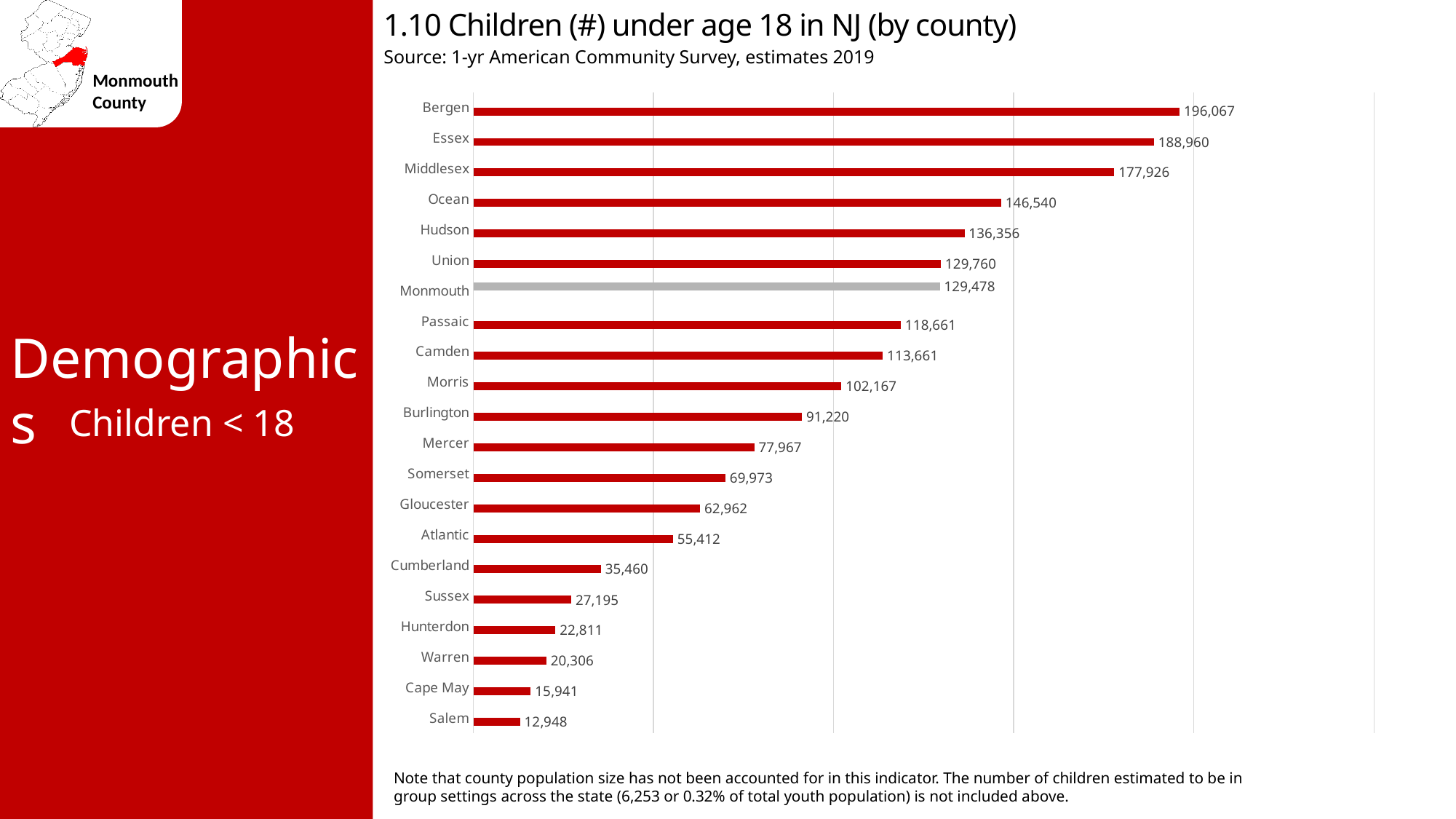
Which county has more children under age 18, Hudson or Passaic? Hudson What is the difference between the number of children under 18 in Union and Monmouth counties? 282 What is the number of children under age 18 in Monmouth County? 129,478 What type of chart is used on this slide? Bar chart What is the difference between the number of children under 18 in Bergen and Essex counties? 7,107 What is the number of children under age 18 in Ocean County? 146,540 Which county's bar is shown in grey instead of red? Monmouth What is the number of children under age 18 in Cape May County? 15,941 How many counties are shown in the chart? 21 Which county has more children under age 18, Sussex or Cumberland? Cumberland Which county has the lowest number of children under age 18? Salem Which county has the highest number of children under age 18? Bergen